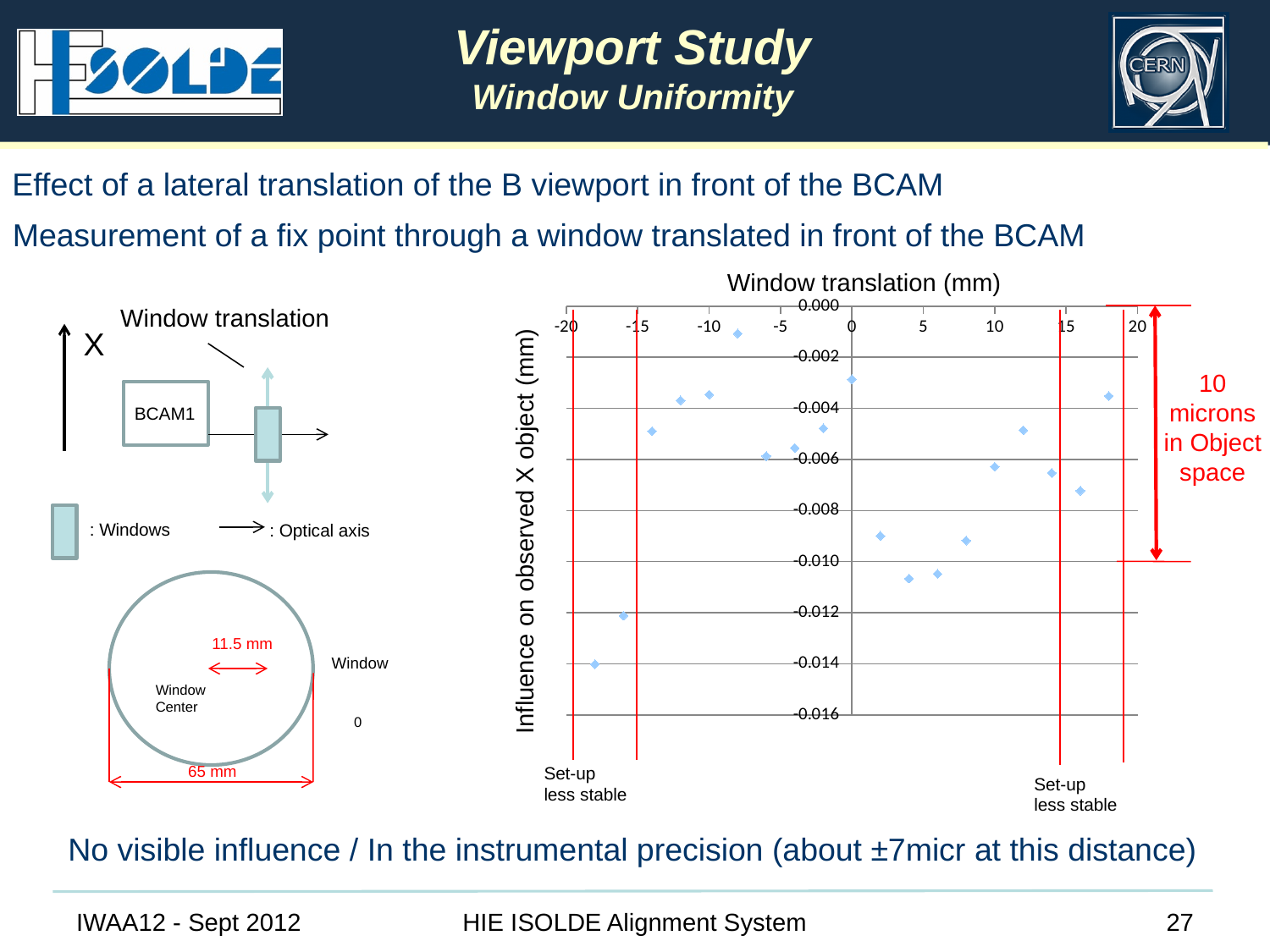
Is the value for the point at a window translation of about -16 mm greater or less than -0.010? less Is the value for the point at a window translation of about -18 mm greater or less than -0.010? less Is the value for the point at a window translation of about 0 mm greater or less than -0.004? greater What is the title of the horizontal axis of the chart? Window translation (mm) Which point has the larger value: the one at a window translation of about -18 mm or the one at about 0 mm? The one at about 0 mm Which point has the larger value: the one at a window translation of about 4 mm or the one at about 12 mm? The one at about 12 mm What kind of chart is shown on the slide? Scatter chart What is the title of the vertical axis of the chart? Influence on observed X object (mm)